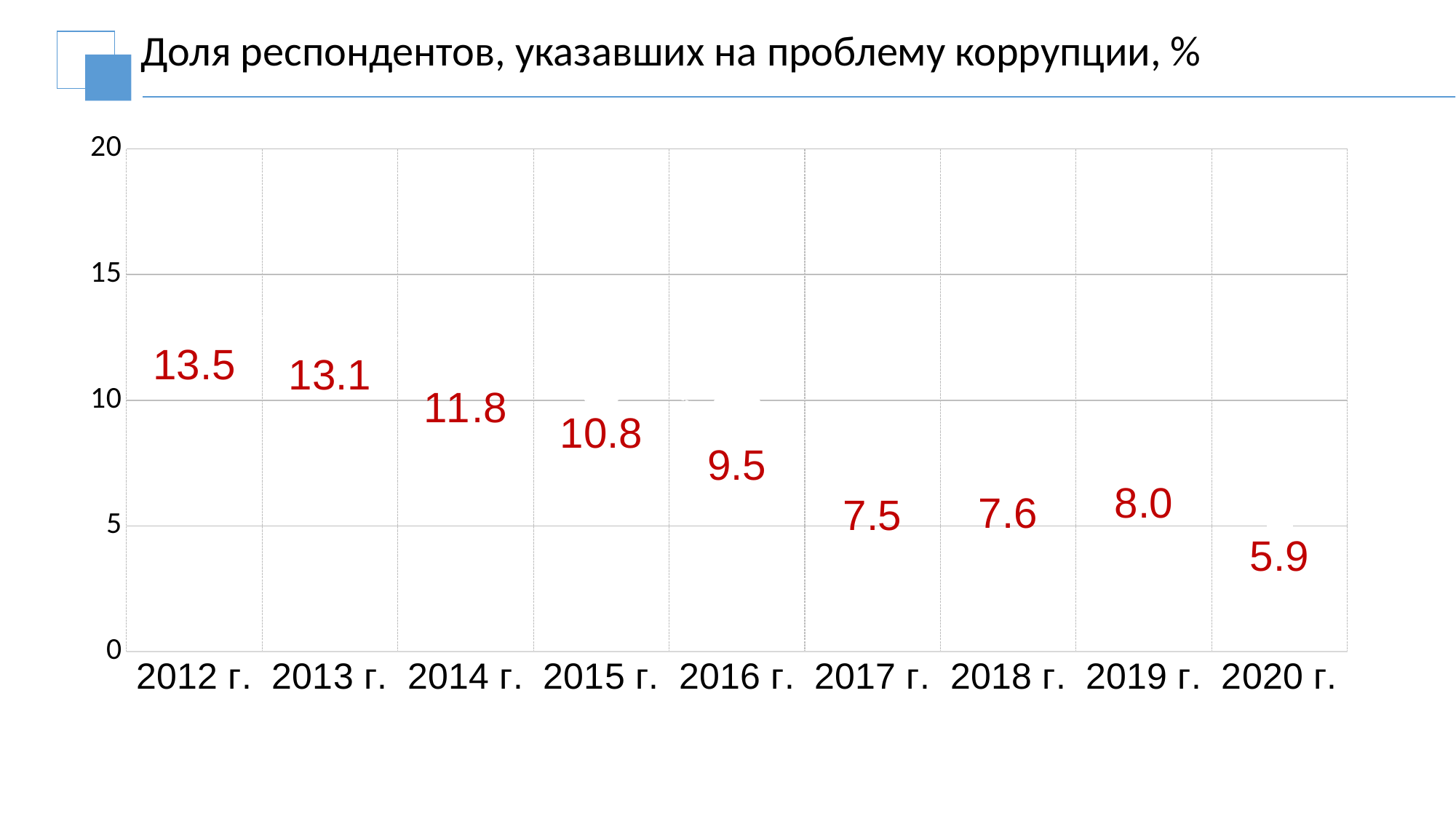
What is the value for 2012 г.? 13.5 Which year has the lowest value? 2020 г. Which is larger, the value for 2017 г. or the value for 2019 г.? 2019 г. Do the values generally rise or fall from 2012 г. to 2020 г.? fall What is the value for 2016 г.? 9.5 What is the value for 2019 г.? 8.0 Which year has the highest value? 2012 г. What is the title of the slide? Доля респондентов, указавших на проблему коррупции, % How many years are shown on the x axis? 9 What is the difference between the values for 2014 г. and 2015 г.? 1.0 What is the difference between the values for 2012 г. and 2020 г.? 7.6 What is the value for 2020 г.? 5.9